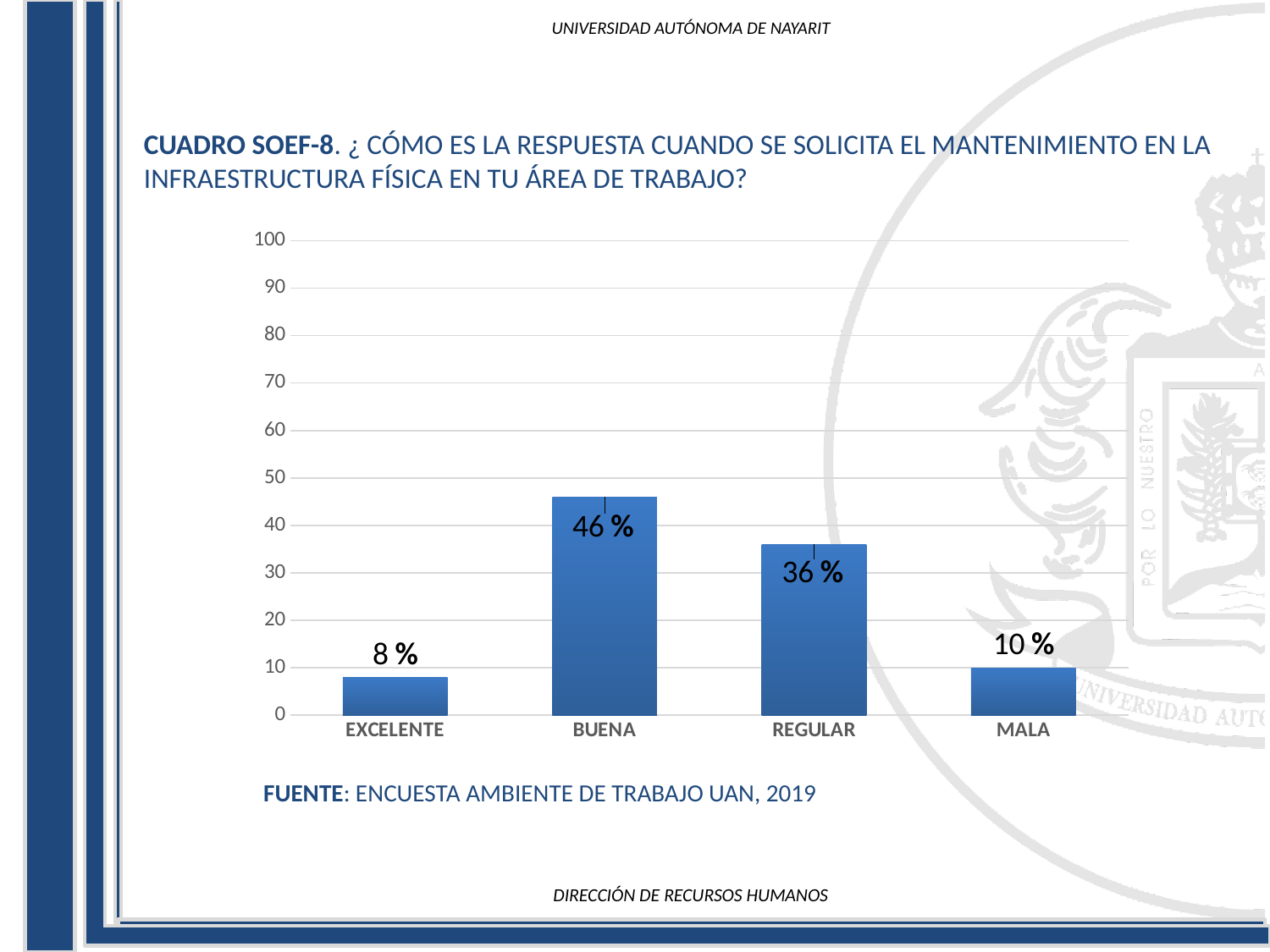
What kind of chart is shown on the slide? bar chart Which is larger, the value for MALA or the value for EXCELENTE? MALA What is the difference between the values for BUENA and REGULAR? 10 % What is the value for EXCELENTE? 8 % What is the source cited below the chart? ENCUESTA AMBIENTE DE TRABAJO UAN, 2019 What is the value for BUENA? 46 % Is the value for REGULAR greater or less than 30? greater Which category has the highest value? BUENA What is the value for REGULAR? 36 % What is the value for MALA? 10 % How many categories are shown on the x axis? 4 Which category has the lowest value? EXCELENTE